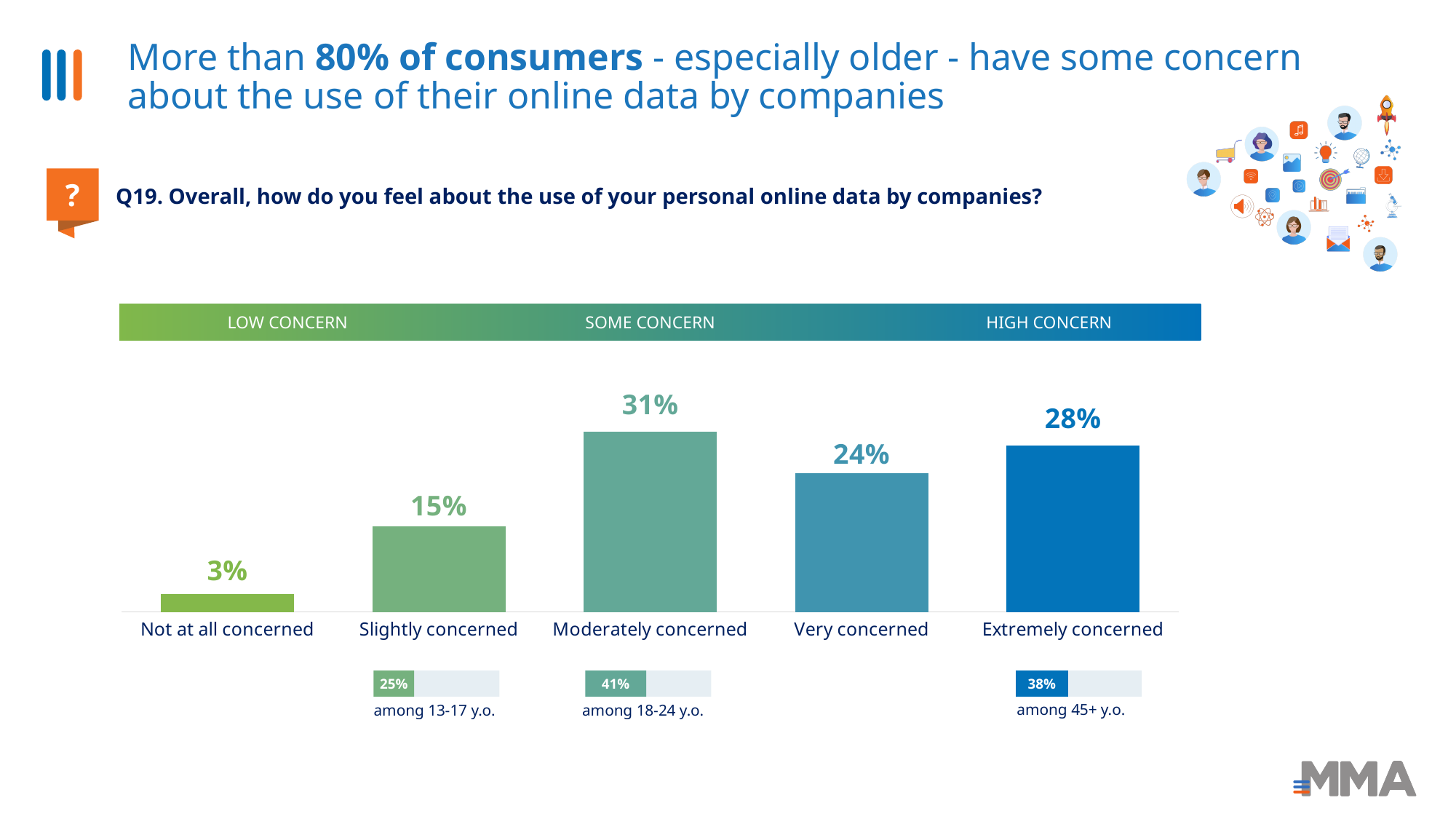
What percentage of 45+ year olds are Extremely concerned, according to the callout below the chart? 38% What is the difference in percentage points between Moderately concerned and Very concerned? 7 What percentage of consumers are Extremely concerned? 28% Which concern level has the lowest share of consumers? Not at all concerned What percentage of consumers are Moderately concerned about the use of their personal online data by companies? 31% What are the three concern groupings labelled in the band above the bars? Low concern, Some concern, High concern Which concern level has the highest share of consumers? Moderately concerned How many concern-level categories are shown in the chart? 5 What type of chart is used to show the concern levels? Bar chart Which is larger: the share of consumers who are Extremely concerned or Very concerned? Extremely concerned What percentage of 18-24 year olds are Moderately concerned, according to the callout below the chart? 41% What percentage of consumers are Not at all concerned? 3%